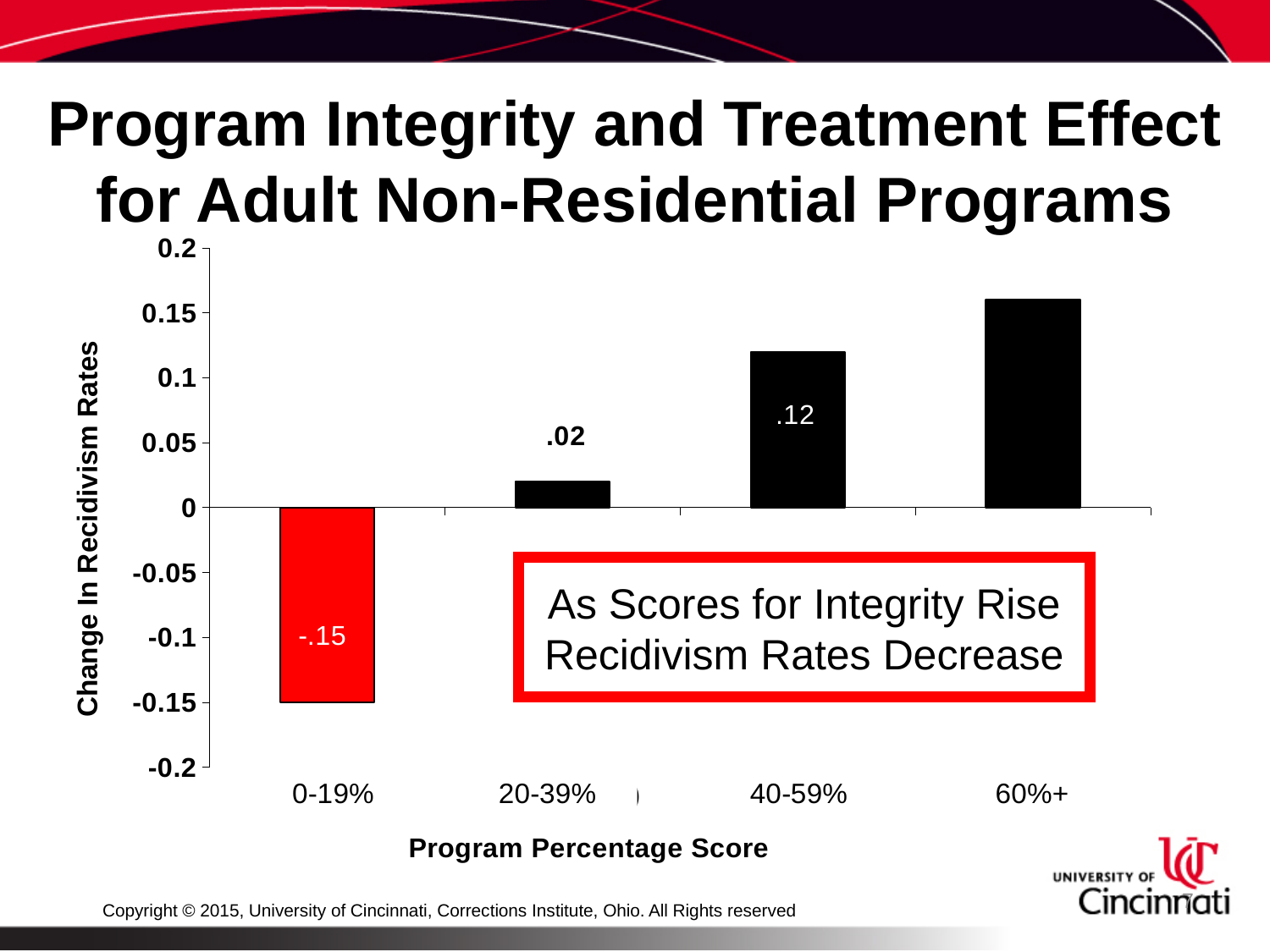
What is the title of the y axis? Change In Recidivism Rates What is the change in recidivism rates for the 0-19% program percentage score group? -.15 Do the values rise or fall as the program percentage score increases along the x axis? rise Which program percentage score group has the lowest change in recidivism rates? 0-19% Which group has the larger value, 20-39% or 40-59%? 40-59% What kind of chart is shown on the slide? bar chart Is the value for the 60%+ group greater or less than 0.15? greater Which program percentage score group has the highest change in recidivism rates? 60%+ What is the difference between the values for the 40-59% group and the 20-39% group? .10 What is the change in recidivism rates for the 40-59% group? .12 How many program percentage score groups are shown on the chart? 4 What is the change in recidivism rates for the 20-39% group? .02